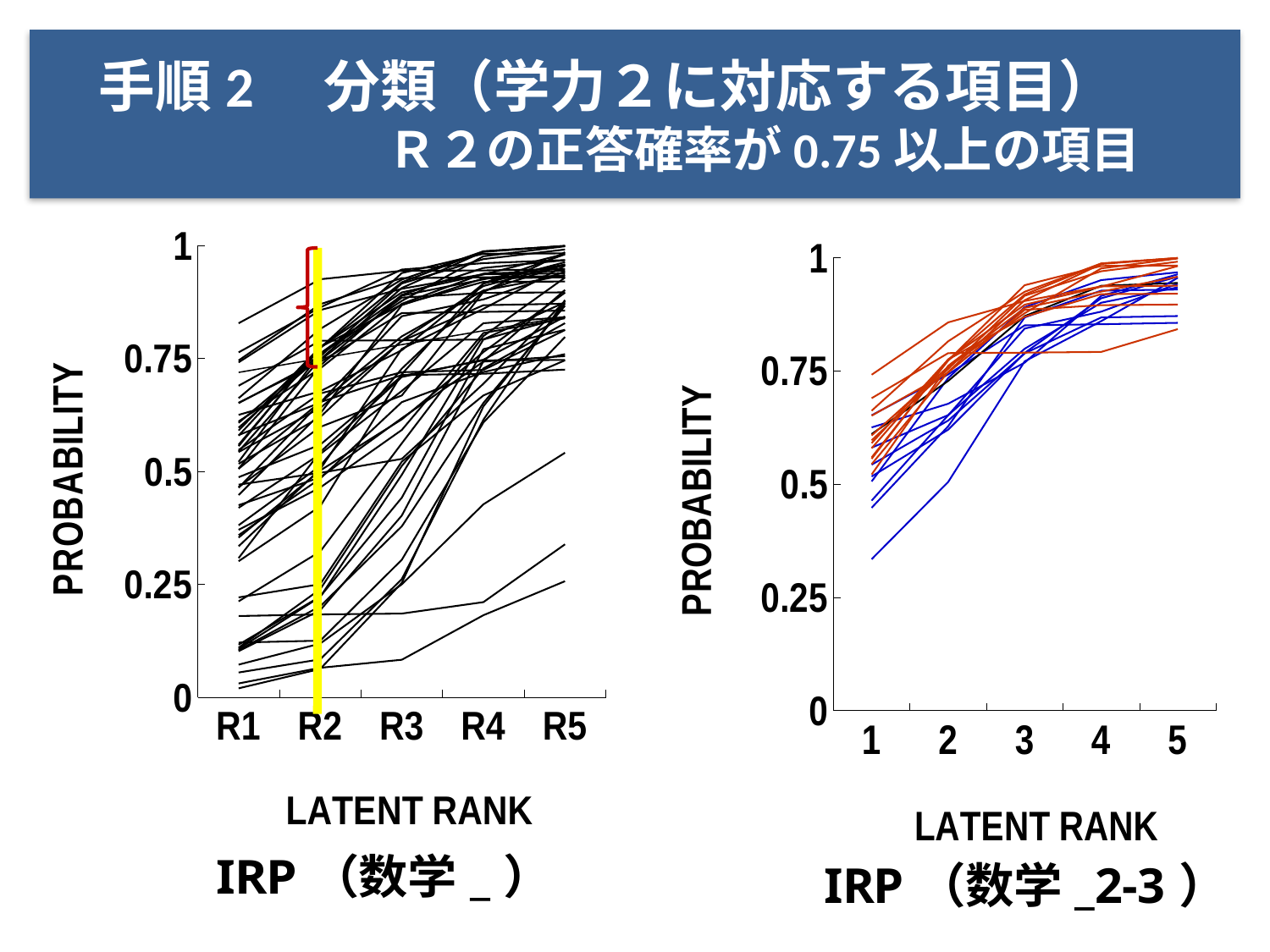
On the left chart, what is the label of the y axis? PROBABILITY What kind of chart is the right chart titled IRP (数学_2-3)? line chart On the right chart, are all line values at latent rank 5 greater or less than 0.75? greater On the left chart, which latent rank is marked by the vertical yellow line? R2 On the left chart, what is the highest value shown on the y axis? 1 On the right chart, is the lowest line value at latent rank 1 greater or less than 0.5? less On the left chart, do the lines generally rise or fall from R1 to R5? rise On the right chart, how many latent rank points are shown on the x axis? 5 What kind of chart is the left chart titled IRP (数学_)? line chart On the left chart, how many latent rank categories are shown on the x axis? 5 On the right chart, do the lines generally rise or fall from latent rank 1 to latent rank 5? rise